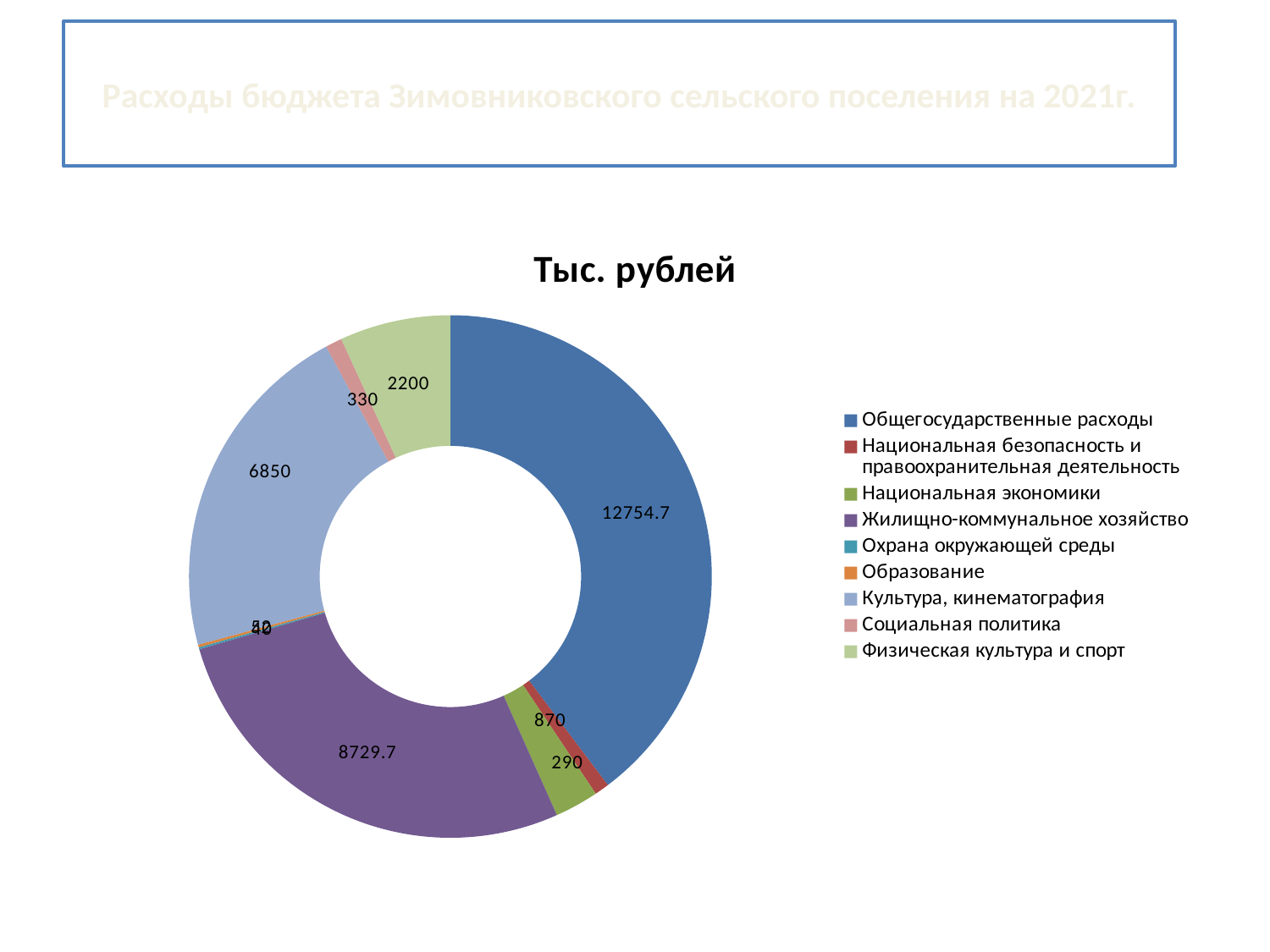
What kind of chart is shown on the slide? doughnut chart How many categories does the chart's legend list? 9 What is the value for Социальная политика? 330 Which is larger, Национальная экономика or Национальная безопасность и правоохранительная деятельность? Национальная экономика What is the value for Физическая культура и спорт? 2200 What is the value for Общегосударственные расходы? 12754.7 Which category has the largest value? Общегосударственные расходы What is the value for Культура, кинематография? 6850 What is the difference between Общегосударственные расходы and Жилищно-коммунальное хозяйство? 4025 Which is larger, Культура, кинематография or Физическая культура и спорт? Культура, кинематография What is the value for Жилищно-коммунальное хозяйство? 8729.7 What is the title of the chart? Тыс. рублей